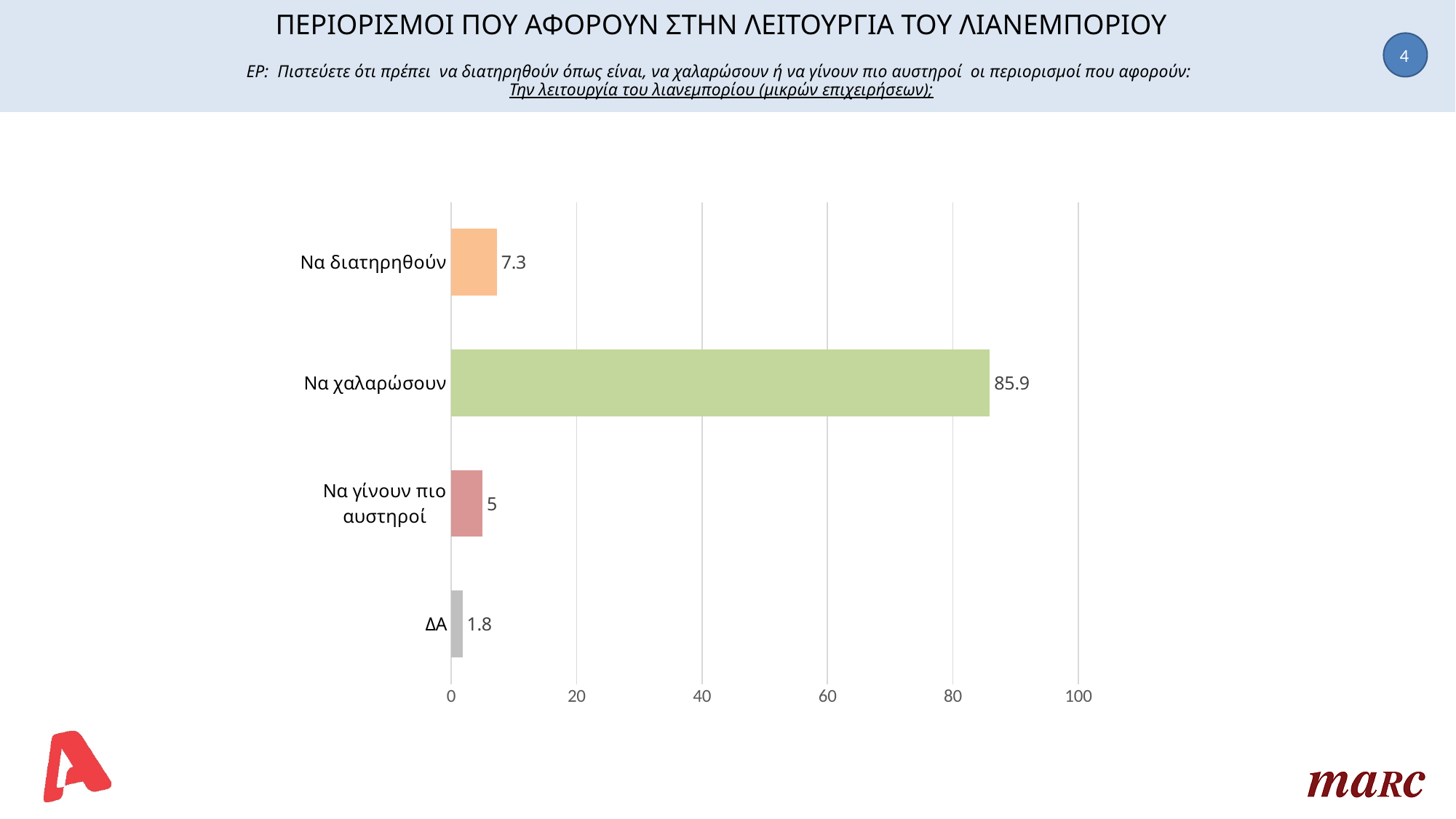
Is the value for Να χαλαρώσουν greater or less than 80? greater What is the difference between the values for Να χαλαρώσουν and Να διατηρηθούν? 78.6 What is the difference between the values for Να διατηρηθούν and Να γίνουν πιο αυστηροί? 2.3 What kind of chart is shown on the slide? bar chart Which is larger, the value for Να διατηρηθούν or the value for Να γίνουν πιο αυστηροί? Να διατηρηθούν What is the value for Να διατηρηθούν? 7.3 Which category has the highest value? Να χαλαρώσουν What is the value for Να γίνουν πιο αυστηροί? 5 What is the value for Να χαλαρώσουν? 85.9 How many categories are shown in the chart? 4 What is the value for ΔΑ? 1.8 Which category has the lowest value? ΔΑ